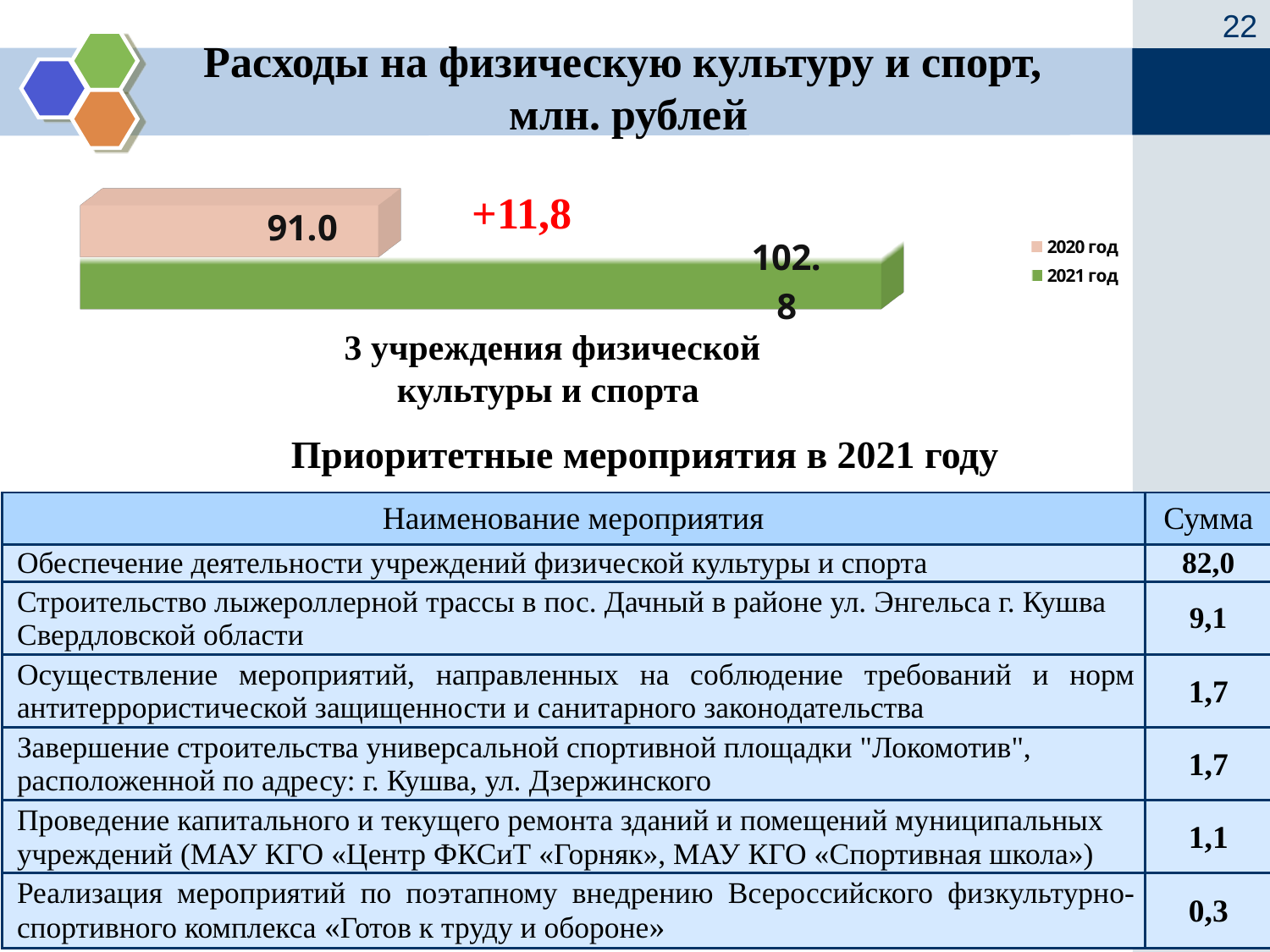
Which year has the lower value in the chart? 2020 год How many bars are plotted in the chart? 2 How many series does the chart legend list? 2 Which colour represents 2021 год in the chart legend? green Is the value for 2021 год larger or smaller than the value for 2020 год? larger Did spending rise or fall from 2020 to 2021 according to the chart? rise What kind of chart is shown on the slide? bar chart What is the title of the chart on the slide? Расходы на физическую культуру и спорт, млн. рублей By how much does the 2021 год value exceed the 2020 год value, as annotated on the chart? +11,8 Which year has the higher value in the chart? 2021 год What is the value for 2021 год in the chart? 102.8 What is the value for 2020 год in the chart? 91.0